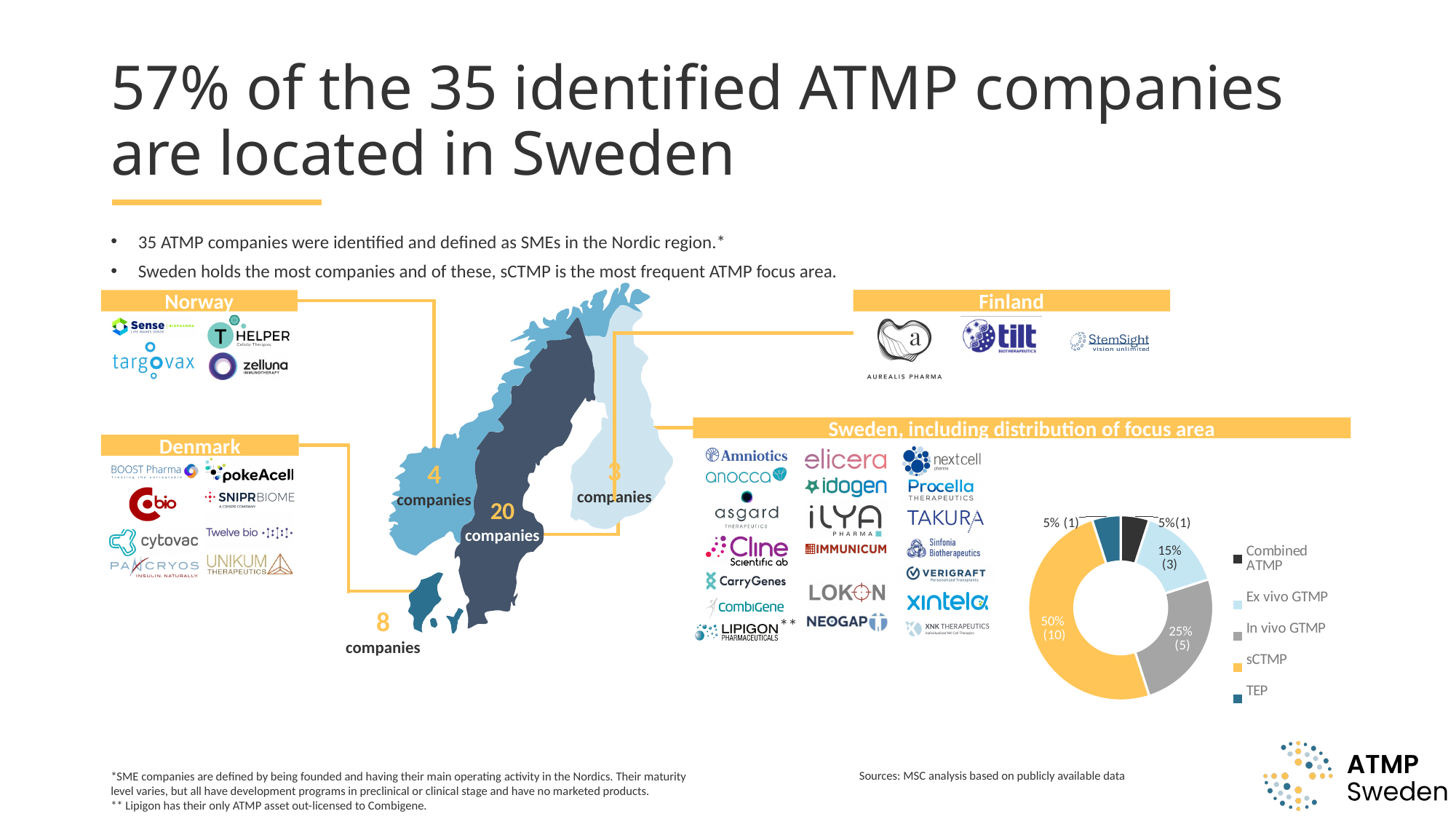
What is the title of the section containing the donut chart? Sweden, including distribution of focus area In the donut chart, which is larger: the share for In vivo GTMP or the share for Ex vivo GTMP? In vivo GTMP In the donut chart, how many more companies are in sCTMP than in Ex vivo GTMP? 7 What colour represents sCTMP in the donut chart? Orange/yellow In the donut chart, what percentage is shown for Ex vivo GTMP? 15% Which focus area has the largest share in the donut chart? sCTMP In the donut chart, how many companies are in the TEP category? 1 In the donut chart, what share of Sweden's ATMP companies have sCTMP as their focus area? 50% In the donut chart, how many companies are in the In vivo GTMP category? 5 How many focus-area categories does the legend of the donut chart list? 5 In the donut chart, what is the difference in percentage points between sCTMP and In vivo GTMP? 25 percentage points What kind of chart is shown on the slide? Donut (pie) chart